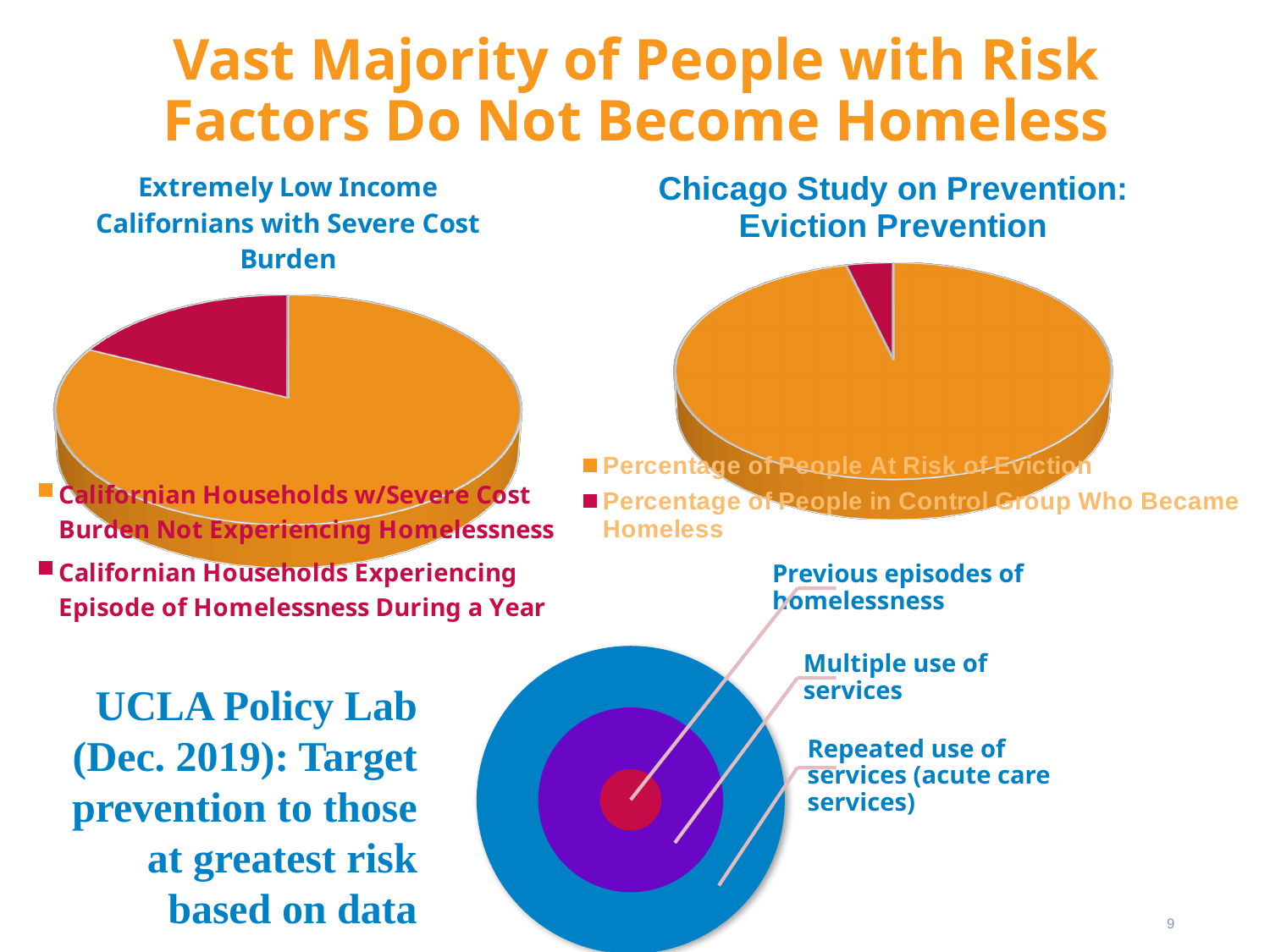
In the 'Extremely Low Income Californians with Severe Cost Burden' chart, what colour is the slice for 'Californian Households Experiencing Episode of Homelessness During a Year'? Red In the 'Chicago Study on Prevention: Eviction Prevention' chart, which category has the largest slice? Percentage of People At Risk of Eviction What is the title of the pie chart on the right side of the slide? Chicago Study on Prevention: Eviction Prevention How many slices does the 'Extremely Low Income Californians with Severe Cost Burden' pie chart have? 2 What kind of chart is the 'Extremely Low Income Californians with Severe Cost Burden' chart? Pie chart What kind of chart is the 'Chicago Study on Prevention: Eviction Prevention' chart? Pie chart In the 'Chicago Study on Prevention: Eviction Prevention' chart, which is larger: the slice for 'Percentage of People At Risk of Eviction' or the slice for 'Percentage of People in Control Group Who Became Homeless'? Percentage of People At Risk of Eviction In the 'Extremely Low Income Californians with Severe Cost Burden' chart, which category has the largest slice? Californian Households w/Severe Cost Burden Not Experiencing Homelessness How many entries does the legend of the 'Chicago Study on Prevention: Eviction Prevention' chart list? 2 In the 'Extremely Low Income Californians with Severe Cost Burden' chart, which category has the smallest slice? Californian Households Experiencing Episode of Homelessness During a Year How many slices does the 'Chicago Study on Prevention: Eviction Prevention' pie chart have? 2 In the 'Chicago Study on Prevention: Eviction Prevention' chart, which category has the smallest slice? Percentage of People in Control Group Who Became Homeless